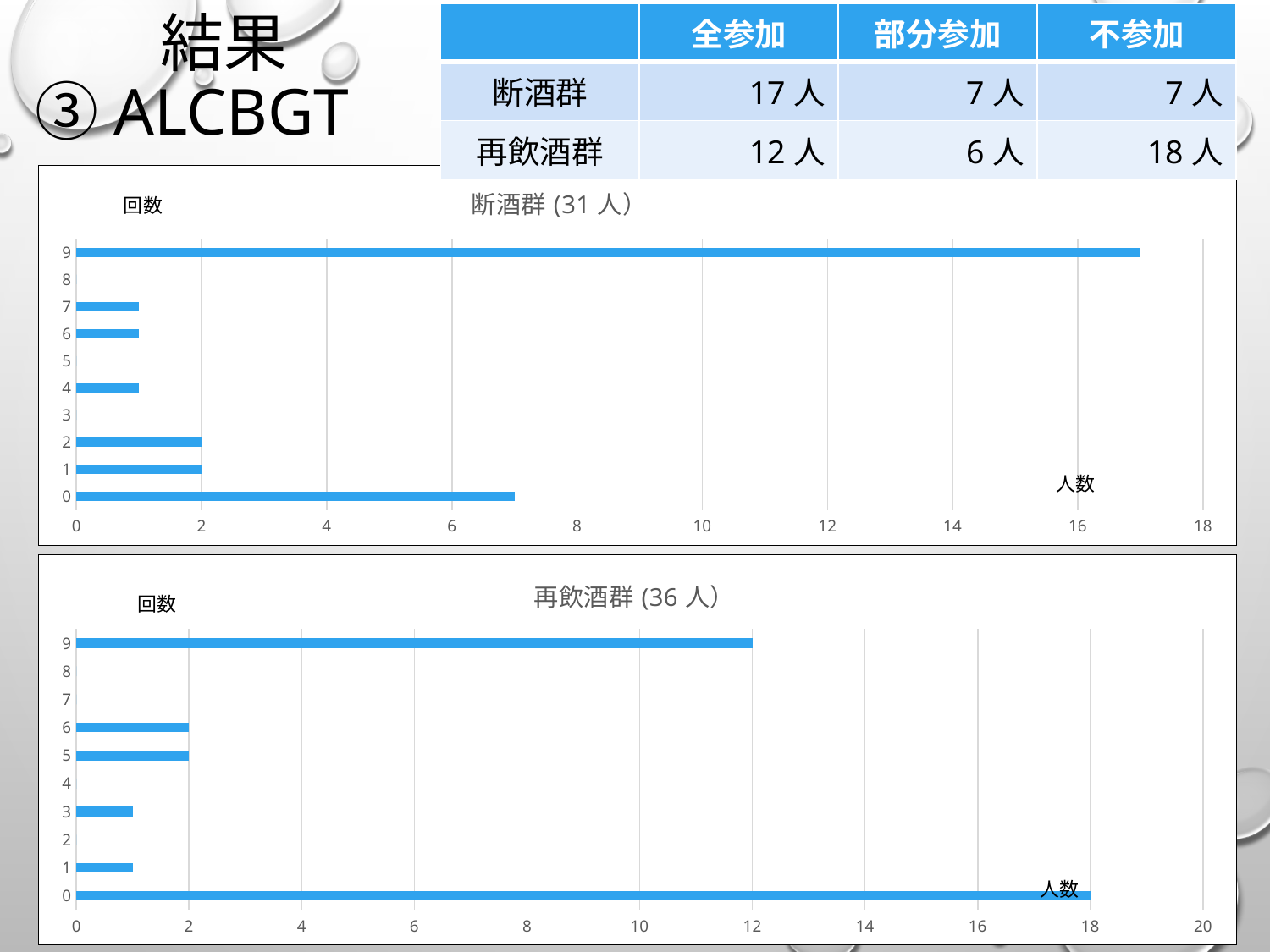
In the bottom chart (再飲酒群), what is the difference between the 人数 for 回数 0 and 回数 9? 6 In the top chart (断酒群), which is larger, the value for 回数 9 or 回数 0? 回数 9 What is the title of the bottom chart? 再飲酒群 (36 人) In the top chart (断酒群), what is the 人数 for 回数 2? 2 In the top chart (断酒群), is the value for 回数 9 greater or less than 16? greater In the top chart (断酒群), which 回数 category has the highest 人数? 9 In the bottom chart (再飲酒群), what is the 人数 for 回数 0? 18 In the bottom chart (再飲酒群), which 回数 category has the highest 人数? 0 In the bottom chart (再飲酒群), what is the 人数 for 回数 9? 12 In the top chart (断酒群), how many 回数 categories are listed on the vertical axis? 10 In the top chart (断酒群), is the value for 回数 0 greater or less than 8? less What kind of chart is the top chart titled 断酒群 (31 人)? bar chart